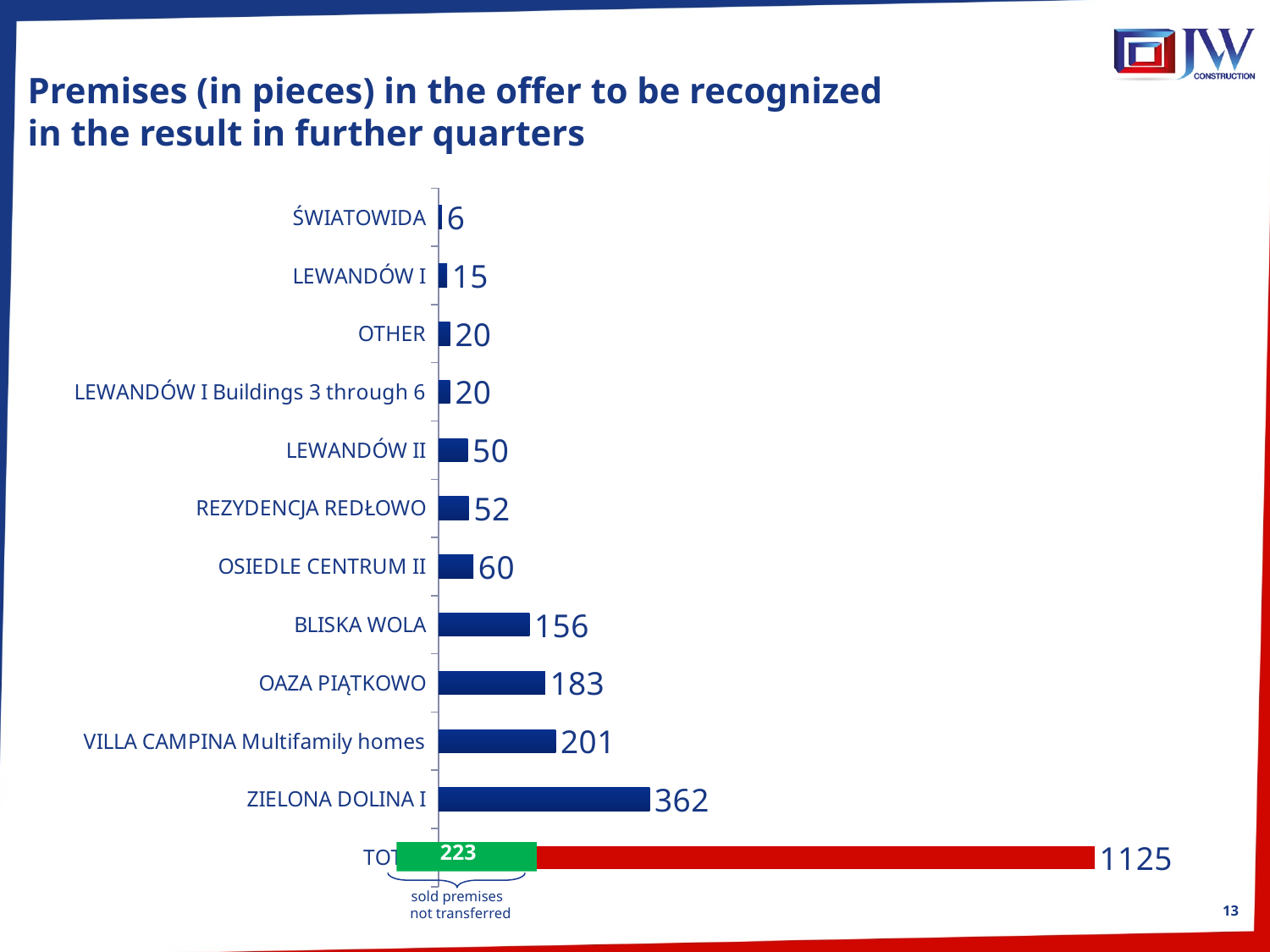
Which is larger, the value for LEWANDÓW II or the value for REZYDENCJA REDŁOWO? REZYDENCJA REDŁOWO What kind of chart is shown on the slide? Bar chart What is the value for BLISKA WOLA? 156 Which category has the lowest value? ŚWIATOWIDA What colour is the TOTAL bar? Red What is the value for ZIELONA DOLINA I? 362 Excluding the TOTAL bar, which category has the highest value? ZIELONA DOLINA I What is the difference between the values for VILLA CAMPINA Multifamily homes and OAZA PIĄTKOWO? 18 What is the value for OSIEDLE CENTRUM II? 60 How many categories, including TOTAL, are shown on the chart? 12 What is the value shown for the TOTAL bar? 1125 How many sold premises not transferred are shown on the TOTAL bar? 223